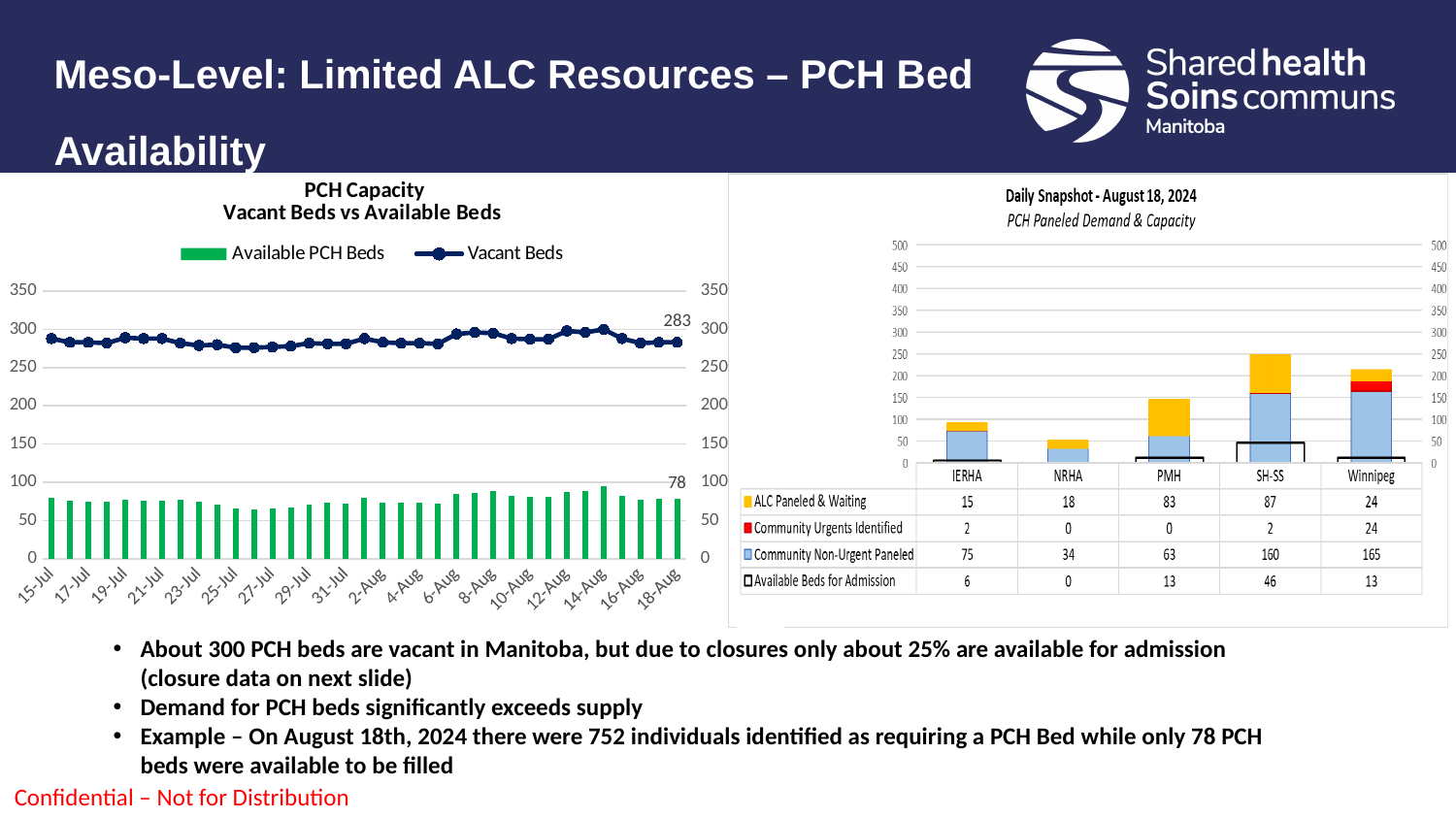
In the Daily Snapshot chart on the right, what is the Community Non-Urgent Paneled value for Winnipeg? 165 In the PCH Capacity chart on the left, what is the Vacant Beds value labelled at 18-Aug? 283 In the Daily Snapshot chart on the right, which region has the highest Community Non-Urgent Paneled value? Winnipeg In the Daily Snapshot chart on the right, which region has the lowest Available Beds for Admission? NRHA In the Daily Snapshot chart on the right, how many Available Beds for Admission are shown for SH-SS? 46 In the PCH Capacity chart on the left, what is the Available PCH Beds value labelled at 18-Aug? 78 In the Daily Snapshot chart on the right, which has more Community Urgents Identified, Winnipeg or IERHA? Winnipeg In the Daily Snapshot chart on the right, what is the ALC Paneled & Waiting value for PMH? 83 In the Daily Snapshot chart on the right, what is the difference between the ALC Paneled & Waiting values for SH-SS and PMH? 4 In the Daily Snapshot chart on the right, how many series does the legend list? 4 In the PCH Capacity chart on the left, is the Vacant Beds value on 15-Jul greater or less than 250? greater In the Daily Snapshot chart on the right, how many regions are shown on the x axis? 5